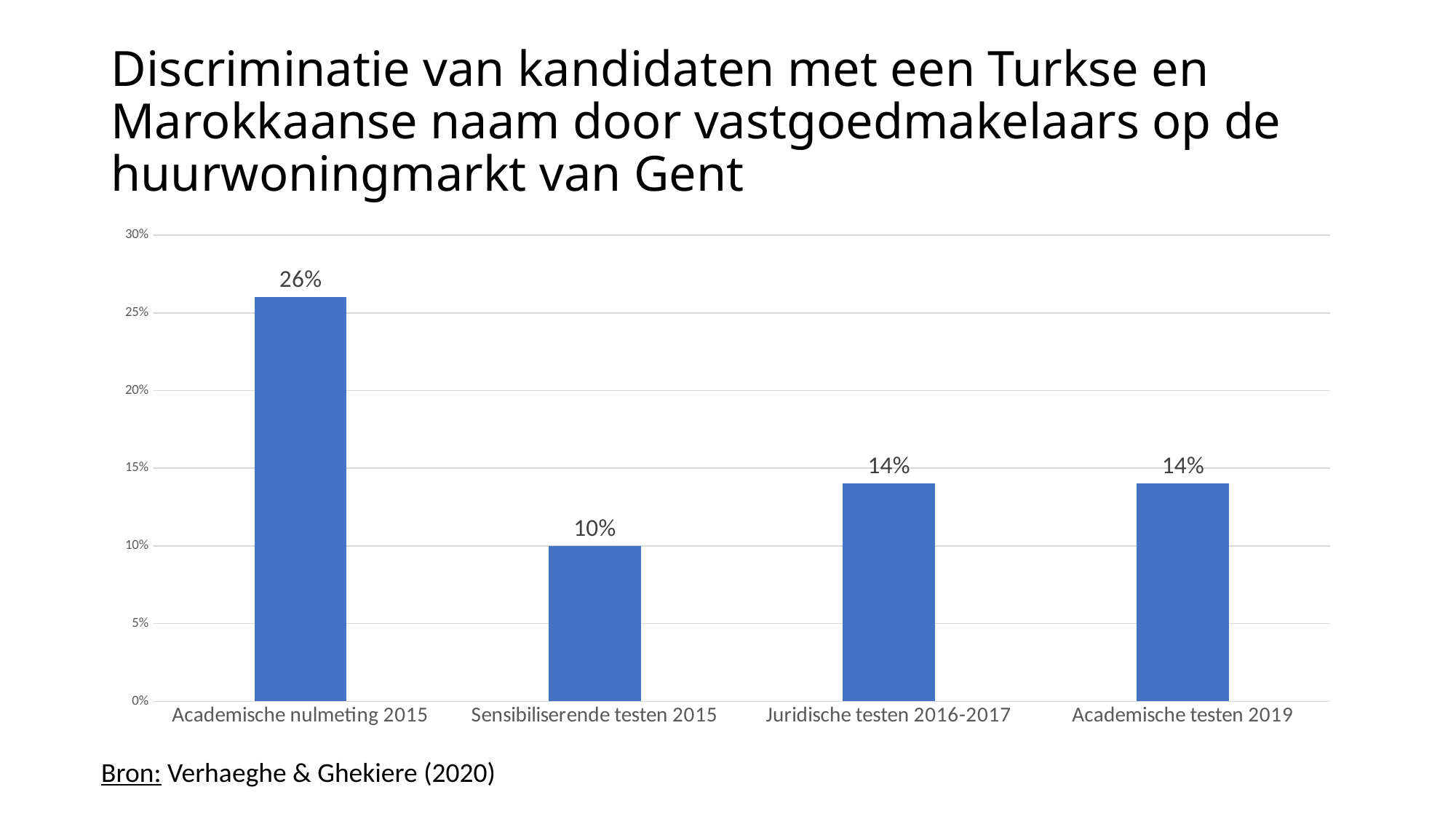
What is the difference between the values for Academische nulmeting 2015 and Sensibiliserende testen 2015? 16% Which is larger, the value for Juridische testen 2016-2017 or the value for Sensibiliserende testen 2015? Juridische testen 2016-2017 What source is cited below the chart? Verhaeghe & Ghekiere (2020) What is the value for Sensibiliserende testen 2015? 10% What kind of chart is shown on the slide? Bar chart Which category has the lowest value? Sensibiliserende testen 2015 What is the difference between the values for Academische nulmeting 2015 and Academische testen 2019? 12% What is the value for Academische testen 2019? 14% What is the value for Academische nulmeting 2015? 26% What is the value for Juridische testen 2016-2017? 14% How many categories are shown in the chart? 4 Which category has the highest value? Academische nulmeting 2015